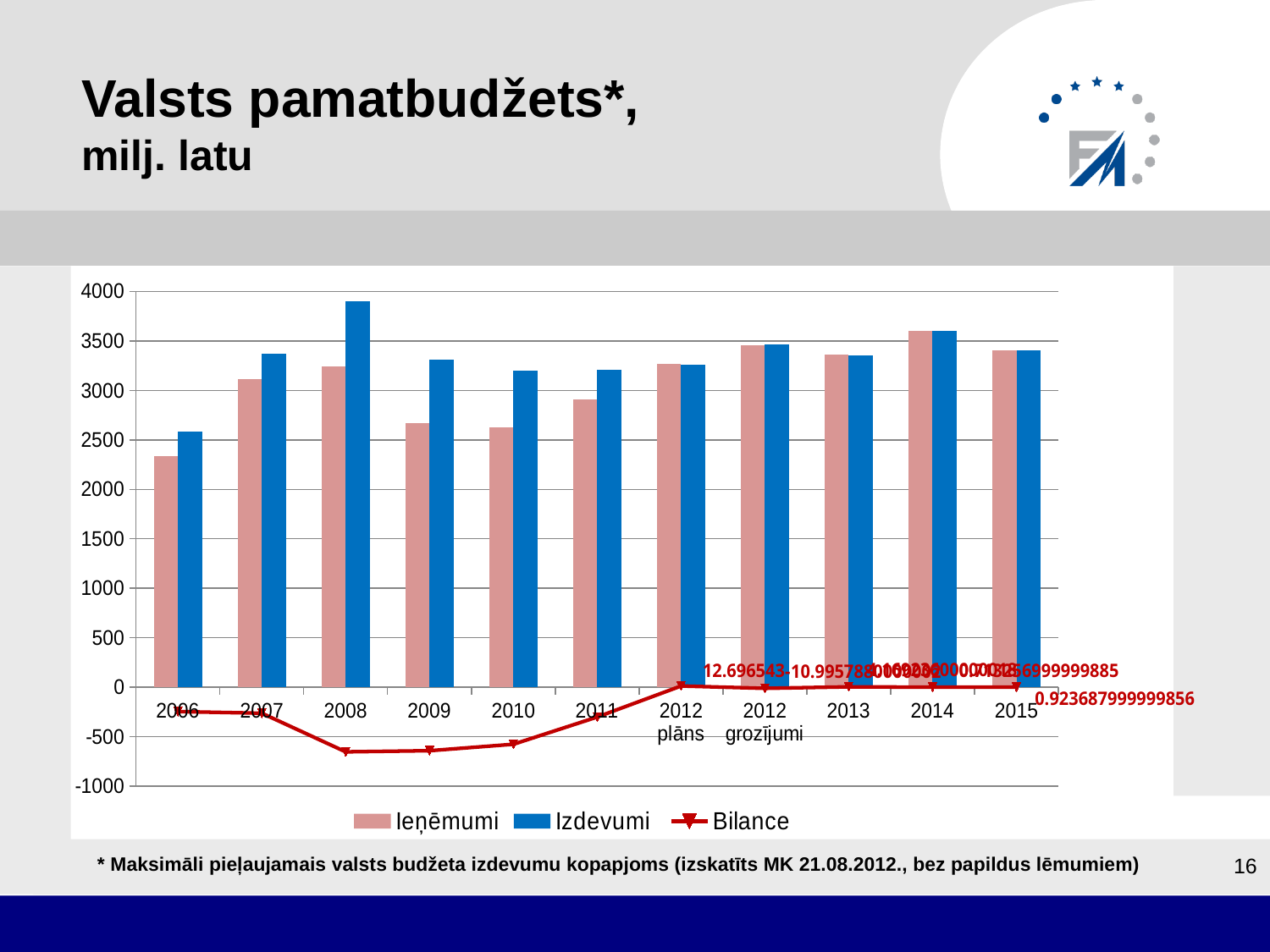
Is the Ieņēmumi value for 2006 greater or less than 2500? less In which year is the Ieņēmumi bar the lowest? 2006 How many series does the chart legend list? 3 Which series is drawn as a red line in the chart? Bilance Is the Bilance value for 2006 greater or less than -500? greater How many categories are shown on the x axis of the chart? 11 Is the Bilance value for 2008 greater or less than -500? less In which year is the Izdevumi bar the highest? 2008 Do the Ieņēmumi values rise or fall from 2006 to 2008? rise What kind of chart is shown on the slide? Bar chart with a line In 2008, which is larger: Ieņēmumi or Izdevumi? Izdevumi